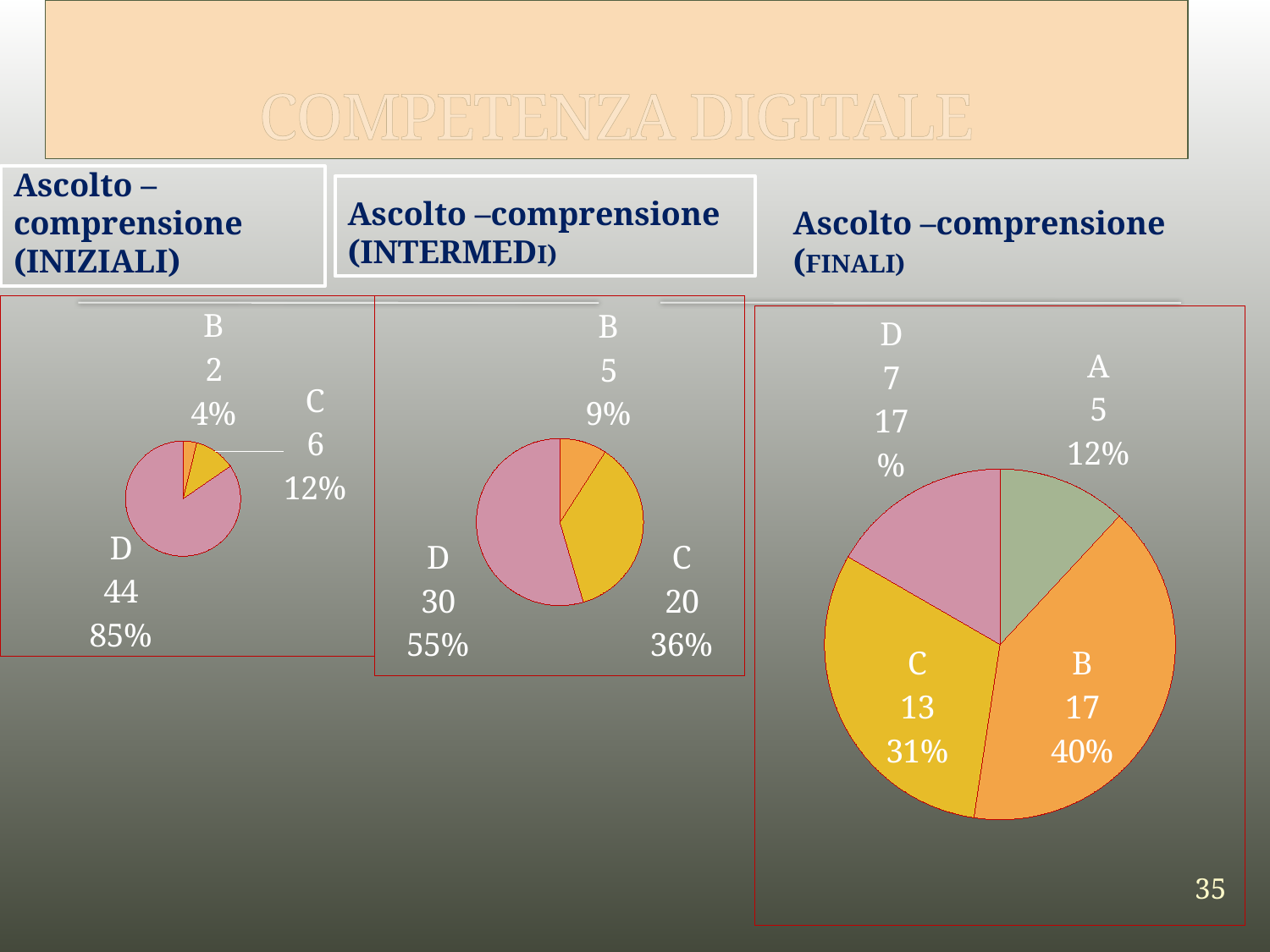
In the INIZIALI pie chart, what is the value for D? 44 In the INTERMEDI pie chart, what share of the pie does D represent? 55% In the INTERMEDI pie chart, what is the difference between the values for D and C? 10 In the FINALI pie chart, what share of the pie does C represent? 31% In the INTERMEDI pie chart, what is the value for C? 20 What kind of chart is used for the INIZIALI data? Pie chart In the INIZIALI pie chart, which category is the largest? D In the FINALI pie chart, which is larger, the value for A or the value for D? D How many categories does the FINALI pie chart show? 4 In the INIZIALI pie chart, what share of the pie does C represent? 12% In the INTERMEDI pie chart, which category is the smallest? B In the FINALI pie chart, what is the value for B? 17